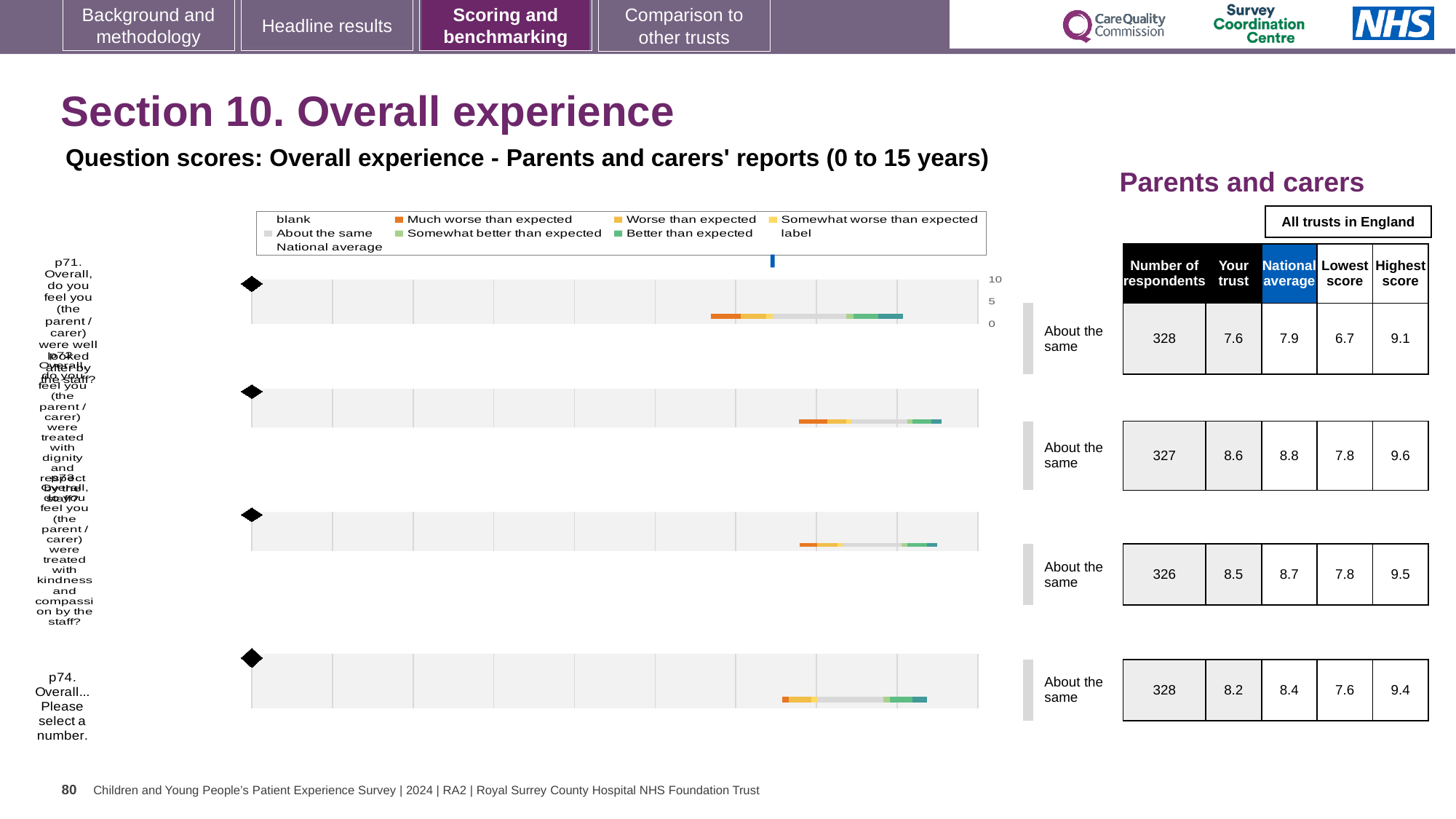
What is the national average for the second row (p72, treated with dignity and respect)? 8.8 What benchmark category is shown next to each of the four question rows? About the same What kind of chart is used to show the question scores on this slide? Bar chart Which question row has the lowest 'Your trust' score? p71 (7.6) How many questions (rows) are plotted in the benchmarking chart? 4 What is the 'Your trust' score for the first row (p71, were you well looked after by the staff)? 7.6 For the first row (p71), what is the difference between the national average and the 'Your trust' score? 0.3 Is the 'Your trust' score for the last row (p74) greater or less than 5 on the chart axis? greater What is the number of respondents for the third row (p73, treated with kindness and compassion)? 326 For the third row (p73), which is larger: the 'Your trust' score or the national average? National average Which question row has the highest 'Your trust' score? p72 (8.6) What is the highest score across all trusts in England for the last row (p74, Overall... Please select a number)? 9.4